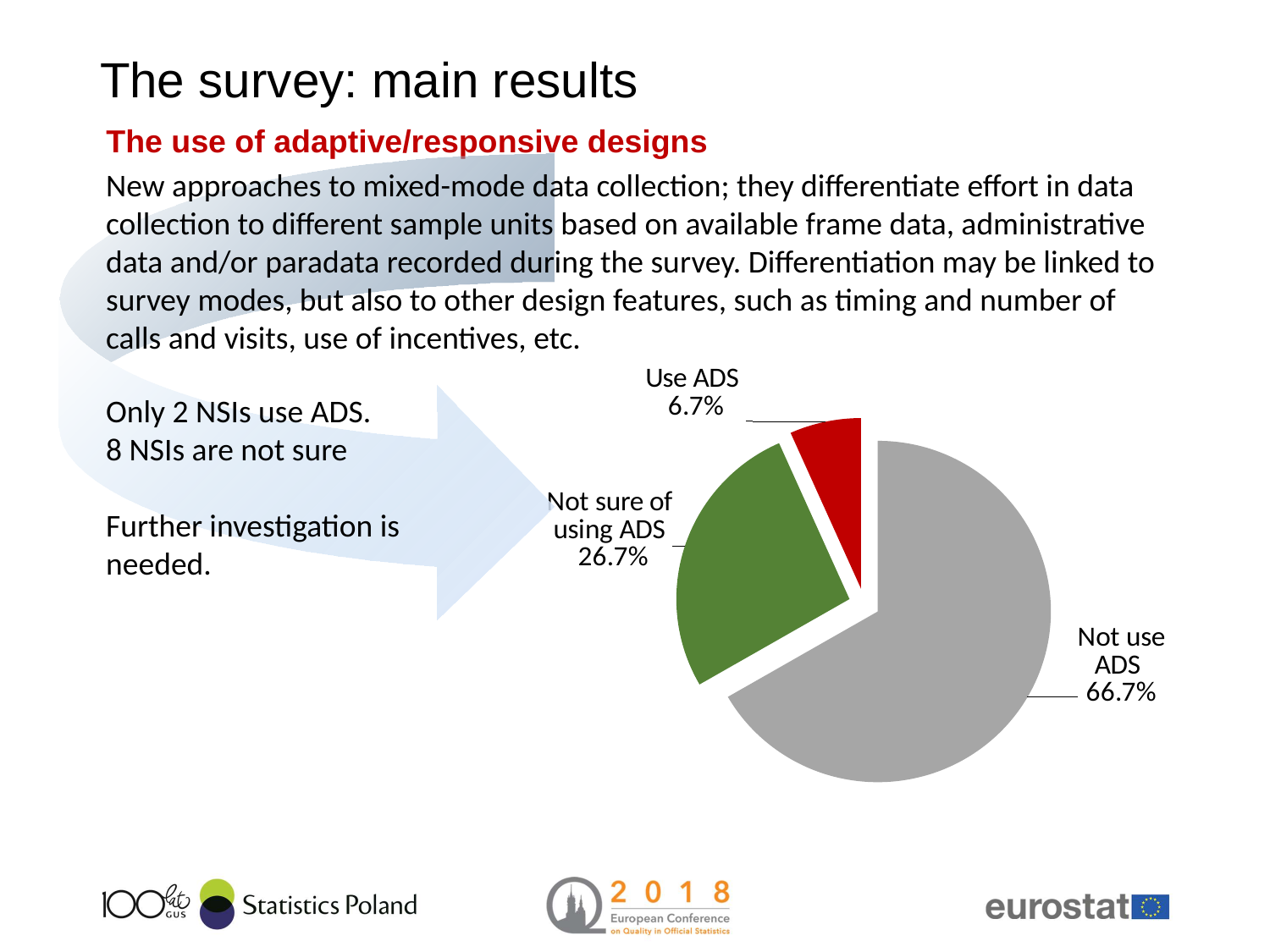
How many slices does the pie chart have? 3 Which slice of the pie is the largest? Not use ADS What share of the pie is labelled "Not sure of using ADS"? 26.7% Which slice of the pie is the smallest? Use ADS What kind of chart is shown on the slide? pie chart What share of the pie is labelled "Use ADS"? 6.7% What share of the pie is labelled "Not use ADS"? 66.7% What is the difference between the "Not use ADS" share and the "Not sure of using ADS" share? 40.0% Which is larger, the "Not sure of using ADS" slice or the "Use ADS" slice? Not sure of using ADS What colour is the "Not use ADS" slice? grey What is the difference between the "Not sure of using ADS" share and the "Use ADS" share? 20.0% What colour is the "Use ADS" slice? red